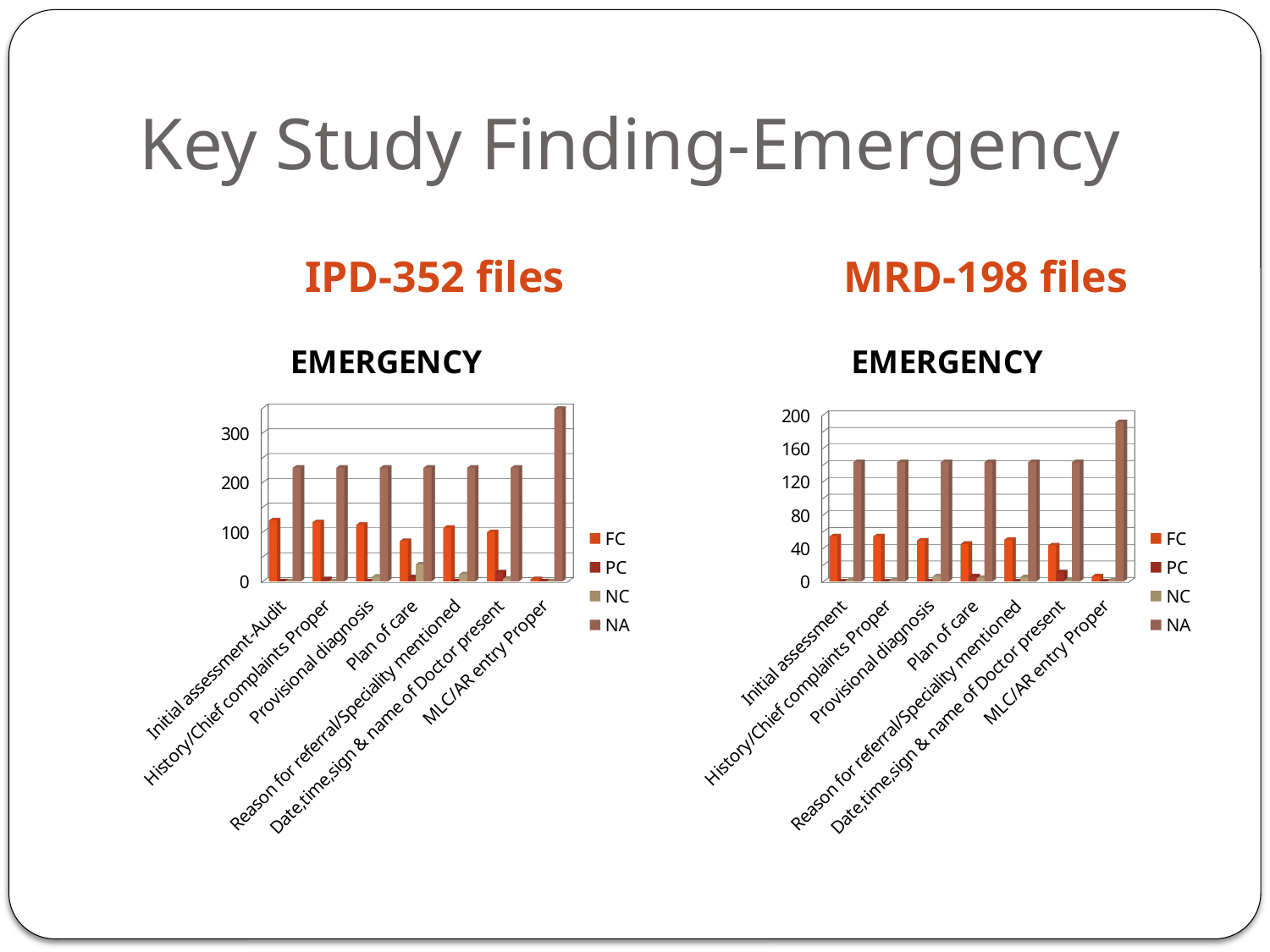
On the left chart (IPD-352 files), is the FC value for Initial assessment-Audit greater or less than 100? greater On the right chart (MRD-198 files), is the NA value for Initial assessment greater or less than 120? greater On the right chart (MRD-198 files), what are the legend entries? FC, PC, NC, NA On the left chart (IPD-352 files), is the NA value for MLC/AR entry Proper greater or less than 300? greater On the left chart (IPD-352 files), how many categories are shown on the x axis? 7 On the right chart (MRD-198 files), which category has the lowest FC value? MLC/AR entry Proper On the left chart (IPD-352 files), how many series does the legend list? 4 On the left chart (IPD-352 files), which category has the highest NA value? MLC/AR entry Proper On the left chart (IPD-352 files), what kind of chart is shown? bar chart On the right chart (MRD-198 files), which series is larger for Plan of care, NA or FC? NA